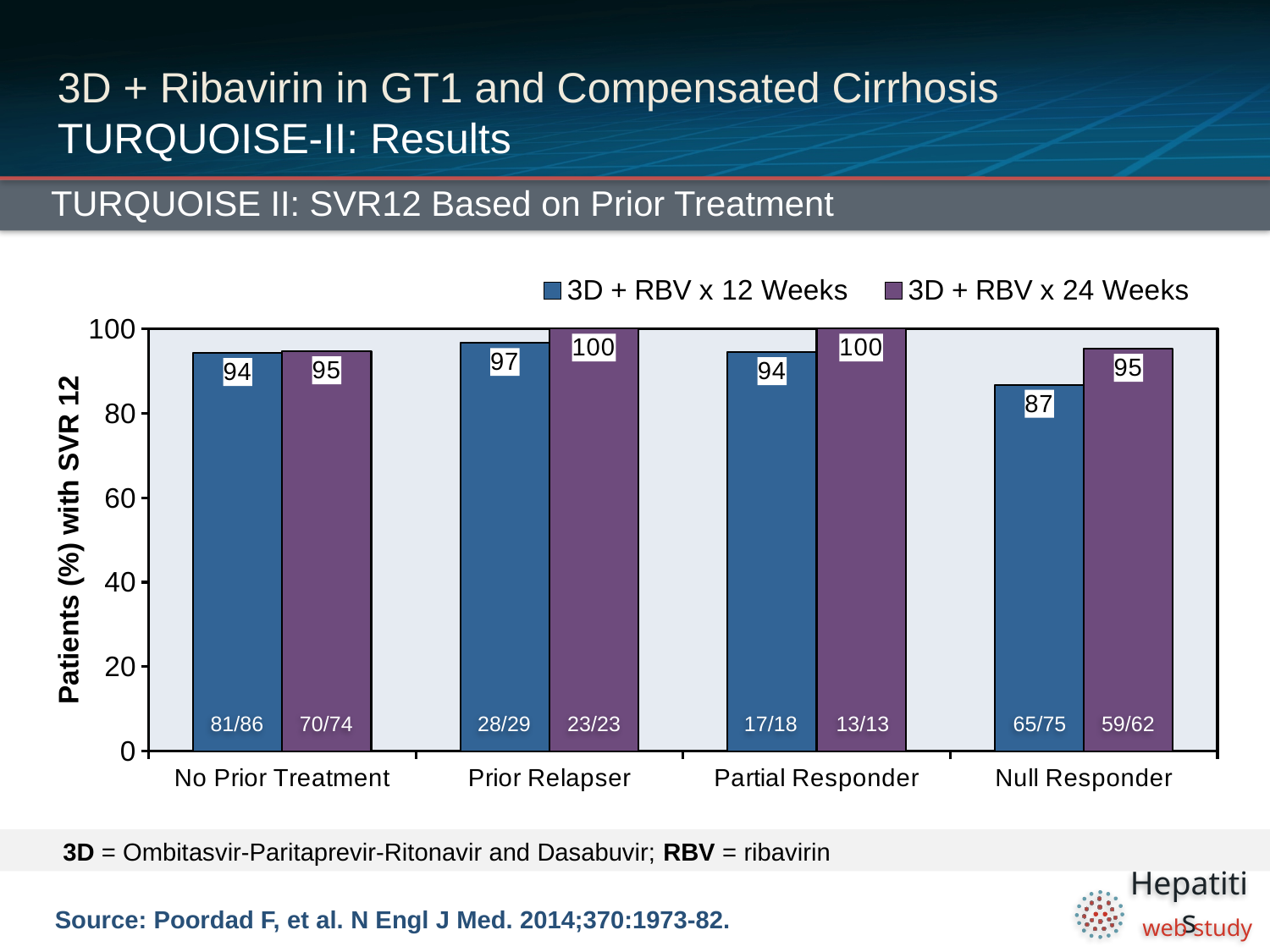
What is the SVR12 rate for the 3D + RBV x 12 Weeks group among patients with No Prior Treatment? 94 What is the difference between the 24-week and 12-week SVR12 rates among Null Responders? 8 What is the patient fraction shown for the 3D + RBV x 24 Weeks group among Null Responders? 59/62 Among Partial Responders, which group has the higher SVR12 rate: 3D + RBV x 12 Weeks or 3D + RBV x 24 Weeks? 3D + RBV x 24 Weeks What kind of chart is shown on the slide? Bar chart Is the SVR12 rate for the 3D + RBV x 12 Weeks group among Null Responders greater or less than 80? greater Which prior treatment category has the lowest SVR12 rate for the 3D + RBV x 12 Weeks group? Null Responder What is the SVR12 rate for the 3D + RBV x 12 Weeks group among Null Responders? 87 What is the SVR12 rate for the 3D + RBV x 24 Weeks group among Prior Relapsers? 100 How many series does the legend list? 2 How many prior treatment categories are shown on the x axis? 4 What is the label of the y axis? Patients (%) with SVR 12